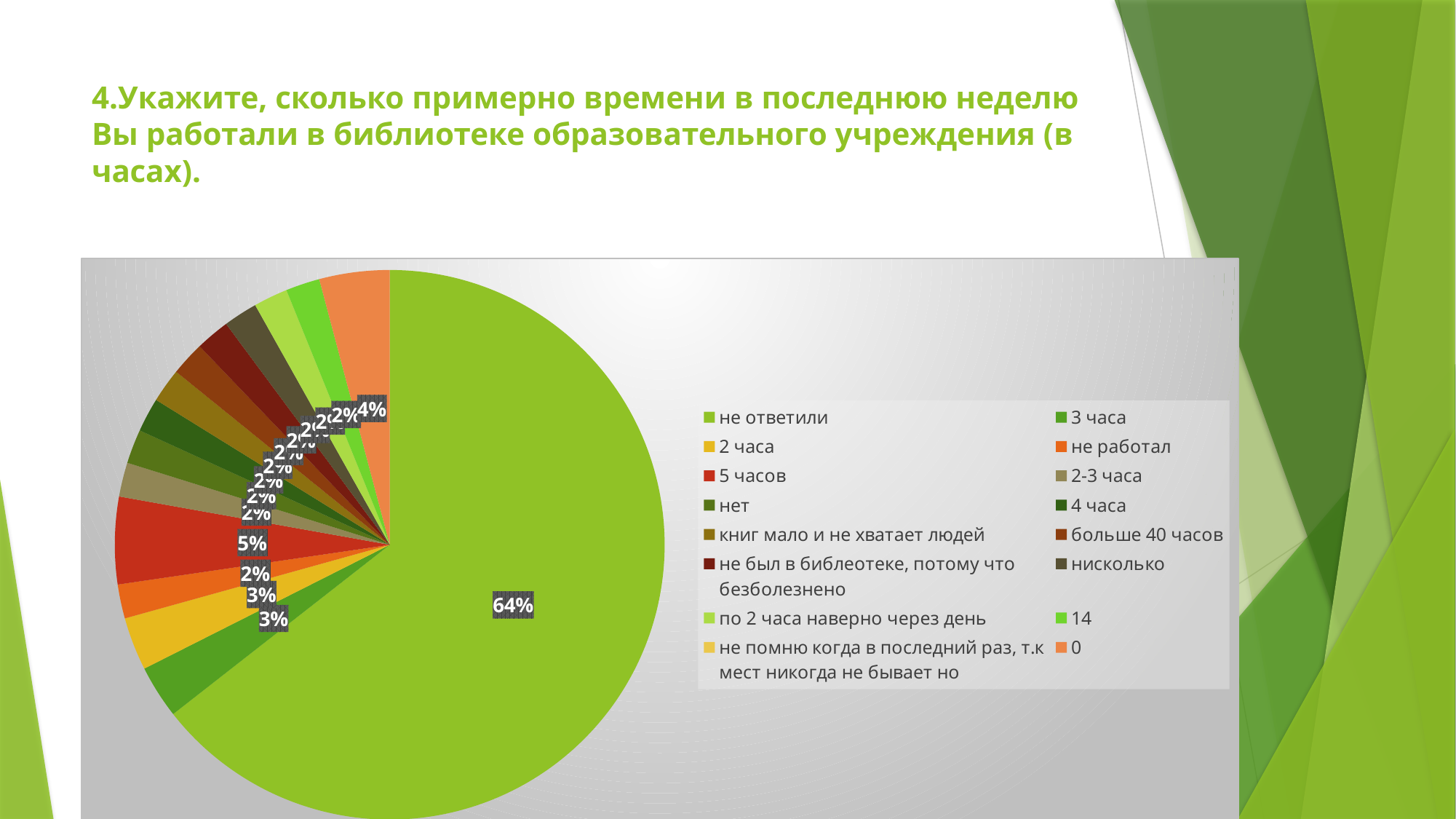
What colour is the slice for "не ответили"? green What is the value shown for the category "0"? 4% What is the value shown for "3 часа"? 3% What is the value shown for "5 часов"? 5% Which category has the largest slice of the pie? не ответили Which is larger, the slice for "5 часов" or the slice for "0"? 5 часов Which is larger, the slice for "3 часа" or the slice for "не работал"? 3 часа What share of the pie does the slice for "не ответили" represent? 64% What is the value shown for "не работал"? 2% How many entries does the legend list? 16 What kind of chart is shown on the slide? pie chart What is the difference between the values for "не ответили" and "5 часов"? 59%